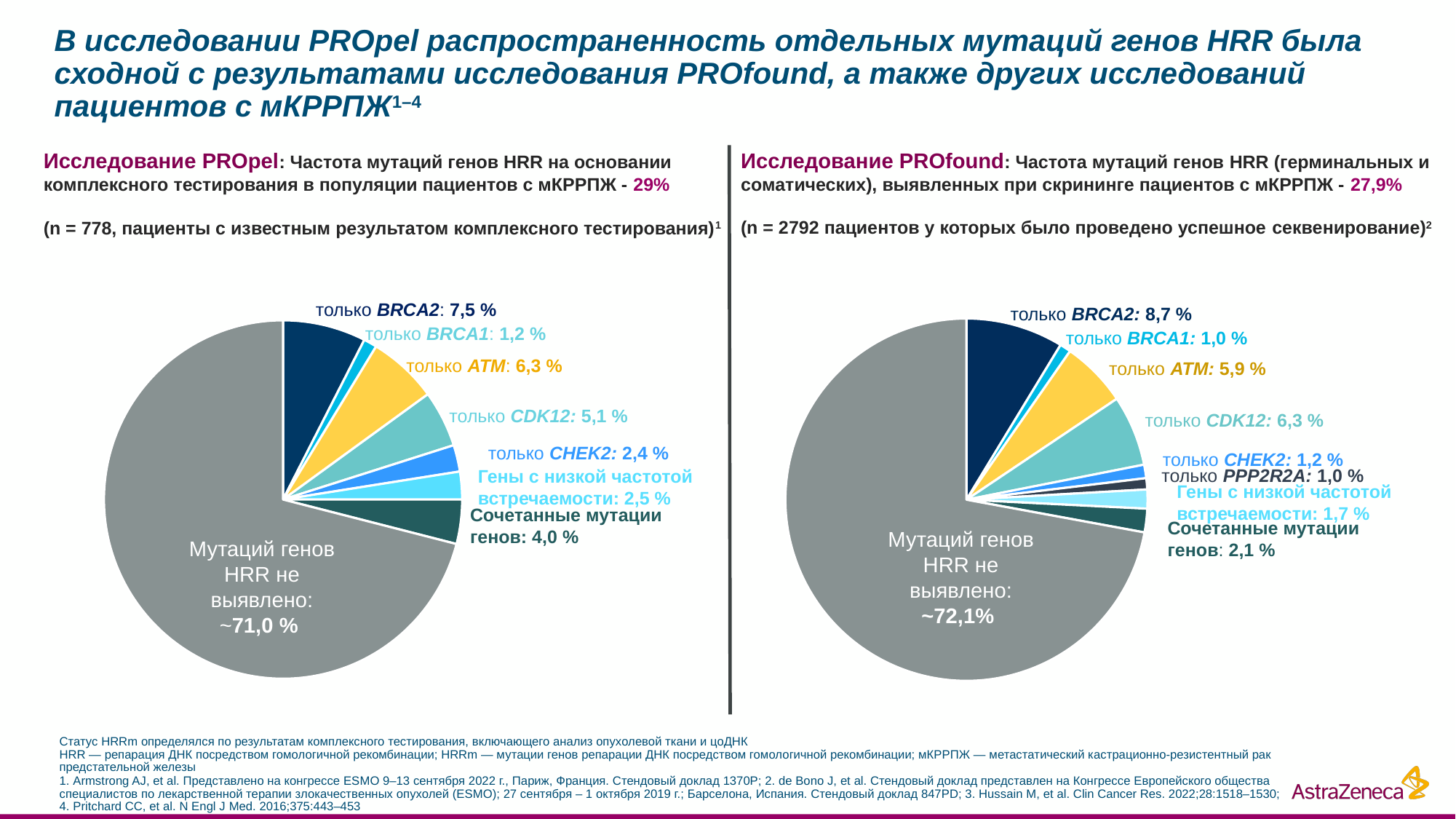
In the PROfound pie chart, which single-gene mutation category ('только ...') has the smallest share? только BRCA1 and только PPP2R2A (1,0 % each) In the PROfound pie chart, what is the difference between the 'только CDK12' and 'только ATM' values? 0,4 % How many slices does the PROpel pie chart have? 8 In the PROfound pie chart, what is the value for 'только PPP2R2A'? 1,0 % What kind of chart is used on the left (PROpel) side of the slide? Pie chart In the PROpel pie chart, what is the value for 'Сочетанные мутации генов'? 4,0 % In the PROpel pie chart, what is the value for 'только BRCA2'? 7,5 % In the PROpel pie chart, what is the difference between the 'только BRCA2' and 'только ATM' values? 1,2 % Which is larger: the 'только CHEK2' value in the PROpel chart or in the PROfound chart? PROpel (2,4 %) How many slices does the PROfound pie chart have? 9 In the PROfound pie chart, what is the value for 'только CDK12'? 6,3 % In the PROpel pie chart, which slice is the largest? Мутаций генов HRR не выявлено